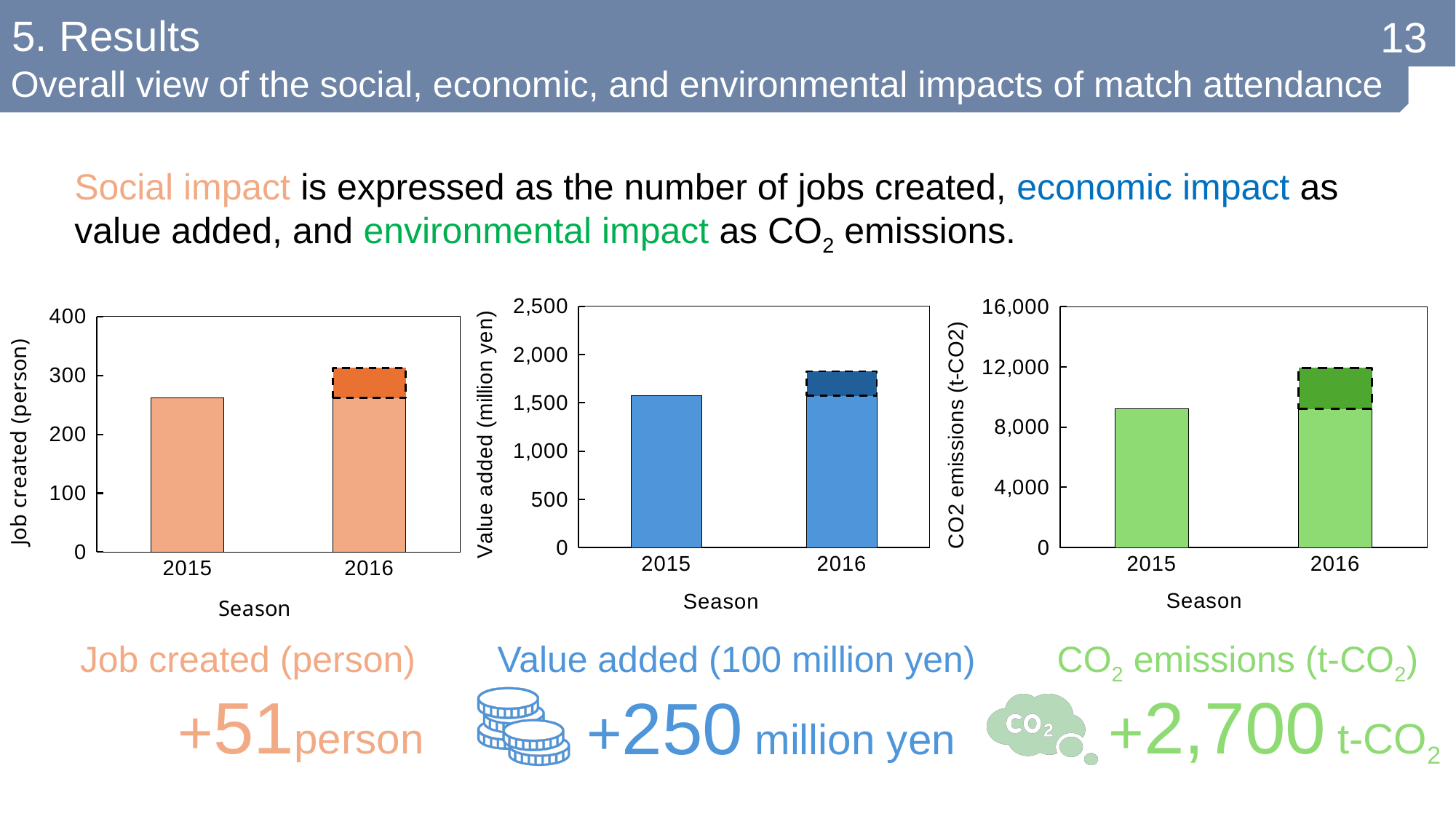
What kind of chart is the left chart showing jobs created? bar chart What is the x-axis label of the right chart (CO2 emissions)? Season In the left chart (Job created), which season has the higher number of jobs created, 2015 or 2016? 2016 In the right chart (CO2 emissions), is the value for 2015 greater or less than 8,000? greater In the middle chart (Value added), is the value for 2015 greater or less than 2,000? less In the left chart (Job created), is the value for 2015 greater or less than 300? less What is the y-axis label of the middle chart? Value added (million yen) In the middle chart (Value added), do the values rise or fall from 2015 to 2016? rise In the right chart (CO2 emissions), which season has the lower CO2 emissions? 2015 In the left chart (Job created), how many seasons are plotted on the x axis? 2